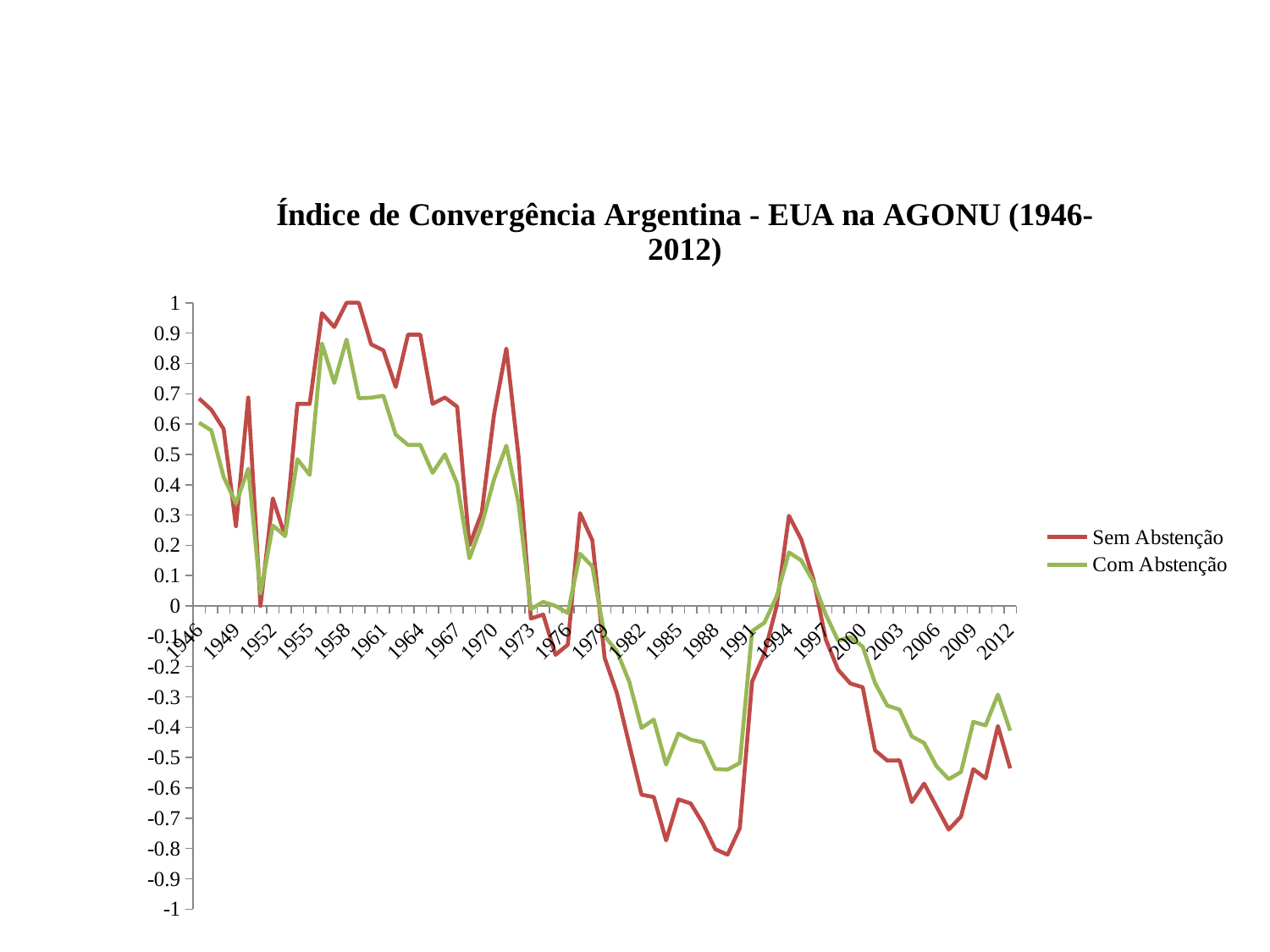
Is the value for Sem Abstenção in 2006 greater or less than -0.5? less How many series does the legend list? 2 What kind of chart is shown on the slide? line chart What is the title of the chart? Índice de Convergência Argentina - EUA na AGONU (1946-2012) In 1988, which series has the higher value, Sem Abstenção or Com Abstenção? Com Abstenção Is the value for Sem Abstenção in 1958 greater or less than 0.5? greater In 1958, which series has the higher value, Sem Abstenção or Com Abstenção? Sem Abstenção Is the value for Sem Abstenção in 1988 greater or less than -0.5? less Which series reaches the lowest value anywhere on the chart? Sem Abstenção What are the two series named in the legend? Sem Abstenção and Com Abstenção